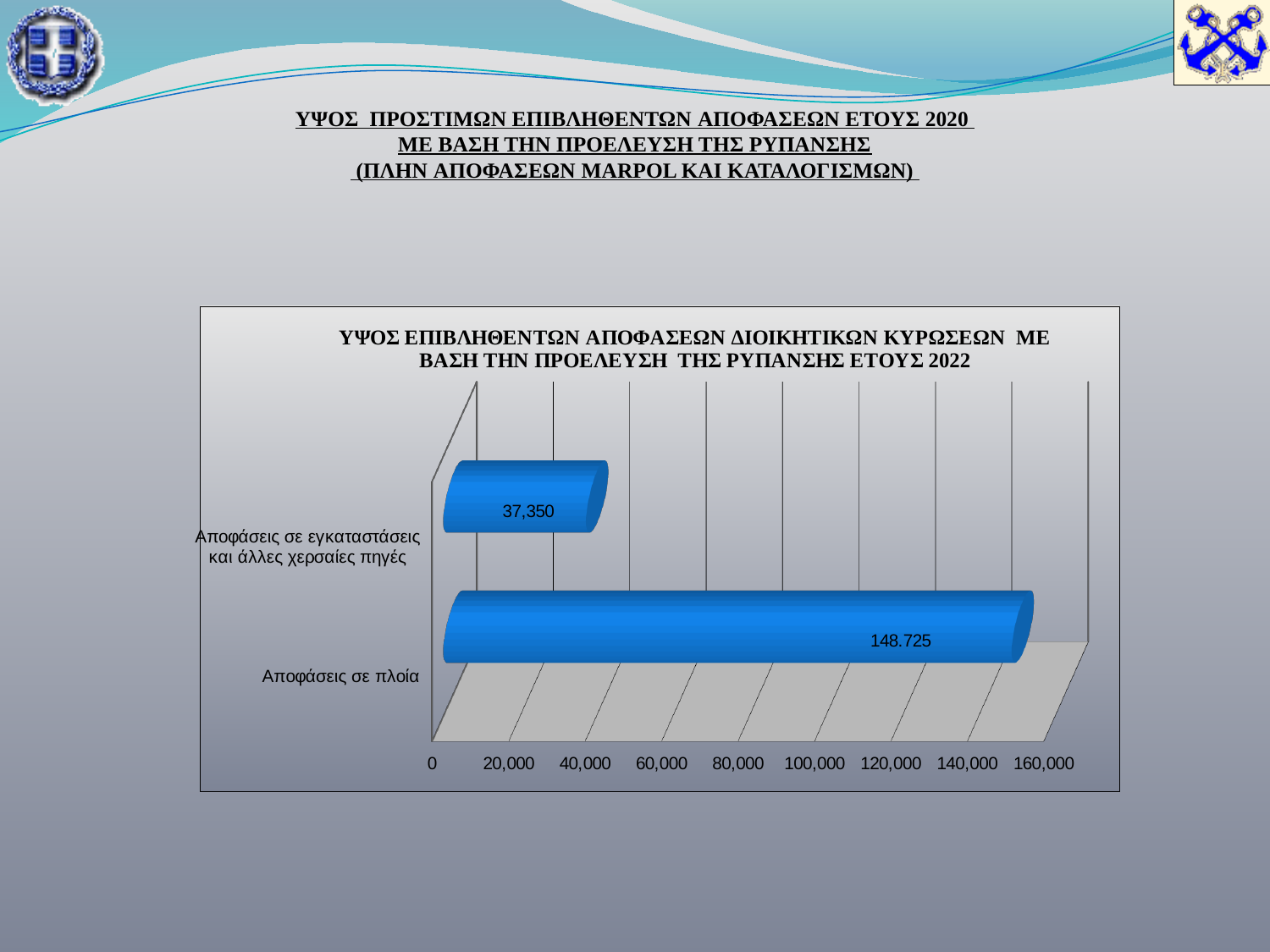
Which category has the lowest value? Αποφάσεις σε εγκαταστάσεις και άλλες χερσαίες πηγές What is the difference between the value for "Αποφάσεις σε πλοία" and the value for "Αποφάσεις σε εγκαταστάσεις και άλλες χερσαίες πηγές"? 111,375 Is the value for "Αποφάσεις σε εγκαταστάσεις και άλλες χερσαίες πηγές" greater or less than 40,000? less What is the value for "Αποφάσεις σε εγκαταστάσεις και άλλες χερσαίες πηγές"? 37,350 Which is larger: the value for "Αποφάσεις σε πλοία" or the value for "Αποφάσεις σε εγκαταστάσεις και άλλες χερσαίες πηγές"? Αποφάσεις σε πλοία What is the title of the chart? ΥΨΟΣ ΕΠΙΒΛΗΘΕΝΤΩΝ ΑΠΟΦΑΣΕΩΝ ΔΙΟΙΚΗΤΙΚΩΝ ΚΥΡΩΣΕΩΝ ΜΕ ΒΑΣΗ ΤΗΝ ΠΡΟΕΛΕΥΣΗ ΤΗΣ ΡΥΠΑΝΣΗΣ ΕΤΟΥΣ 2022 What is the value for "Αποφάσεις σε πλοία"? 148.725 What is the highest value shown on the horizontal axis of the chart? 160,000 How many categories are shown in the chart? 2 What kind of chart is shown on the slide? bar chart Is the value for "Αποφάσεις σε πλοία" greater or less than 140,000? greater Which category has the highest value? Αποφάσεις σε πλοία